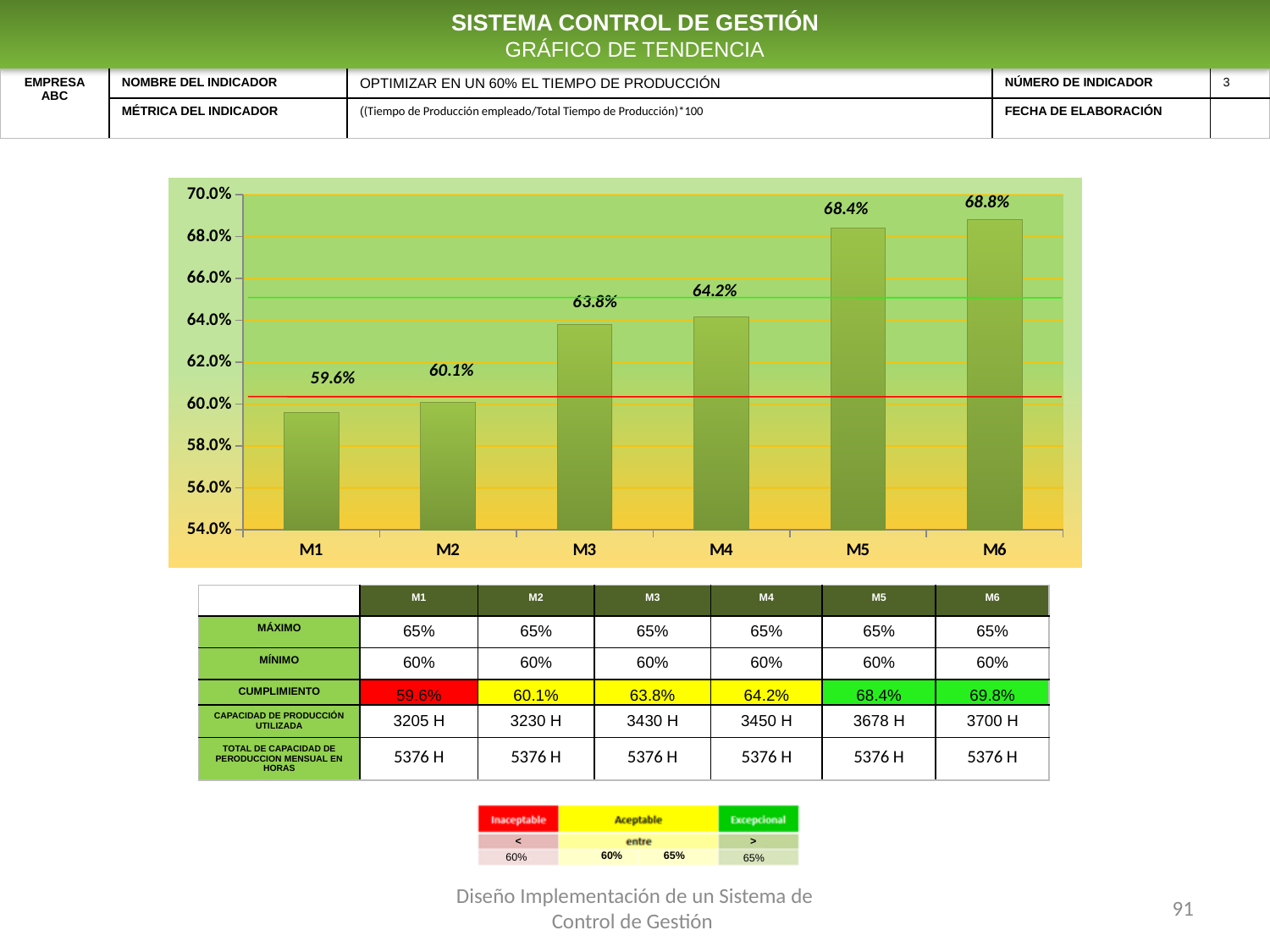
Which category has the lowest value in the chart? M1 What is the value shown for M3 in the chart? 63.8% What is the value shown for M5 in the chart? 68.4% Which is larger in the chart, the value for M2 or the value for M4? M4 What is the difference between the values for M6 and M1 in the chart? 9.2% Which category has the highest value in the chart? M6 What is the value shown for M1 in the chart? 59.6% How many categories are plotted on the x axis of the chart? 6 Is the value for M5 in the chart greater or less than 66.0%? greater Do the values in the chart rise or fall from M1 to M6? rise What is the difference between the values for M4 and M3 in the chart? 0.4% What kind of chart is shown on the slide? bar chart